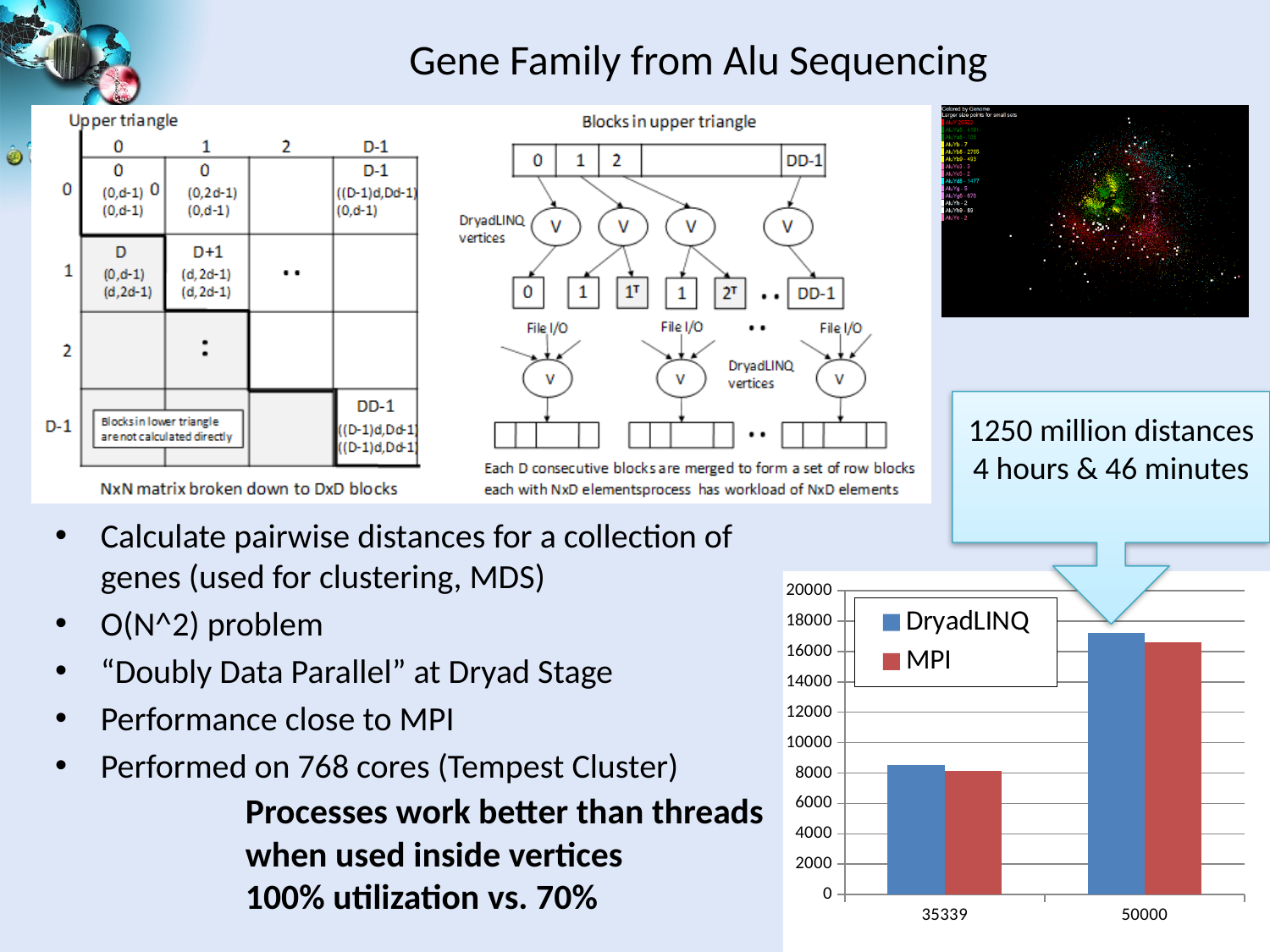
In the bar chart, is the DryadLINQ value for 50000 greater or less than 16000? greater In the bar chart, is the DryadLINQ value for 35339 greater or less than 8000? greater What kind of chart is shown at the bottom right of the slide? bar chart How many categories are shown on the x axis of the bar chart? 2 In the bar chart, which category has the lowest MPI value? 35339 How many series does the legend of the bar chart list? 2 Which series does the blue bar in the bar chart represent? DryadLINQ In the bar chart, do the values for both series rise or fall from 35339 to 50000? rise Which series does the red bar in the bar chart represent? MPI In the bar chart, which category has the higher DryadLINQ value, 35339 or 50000? 50000 In the bar chart, is the MPI value for 50000 greater or less than 18000? less